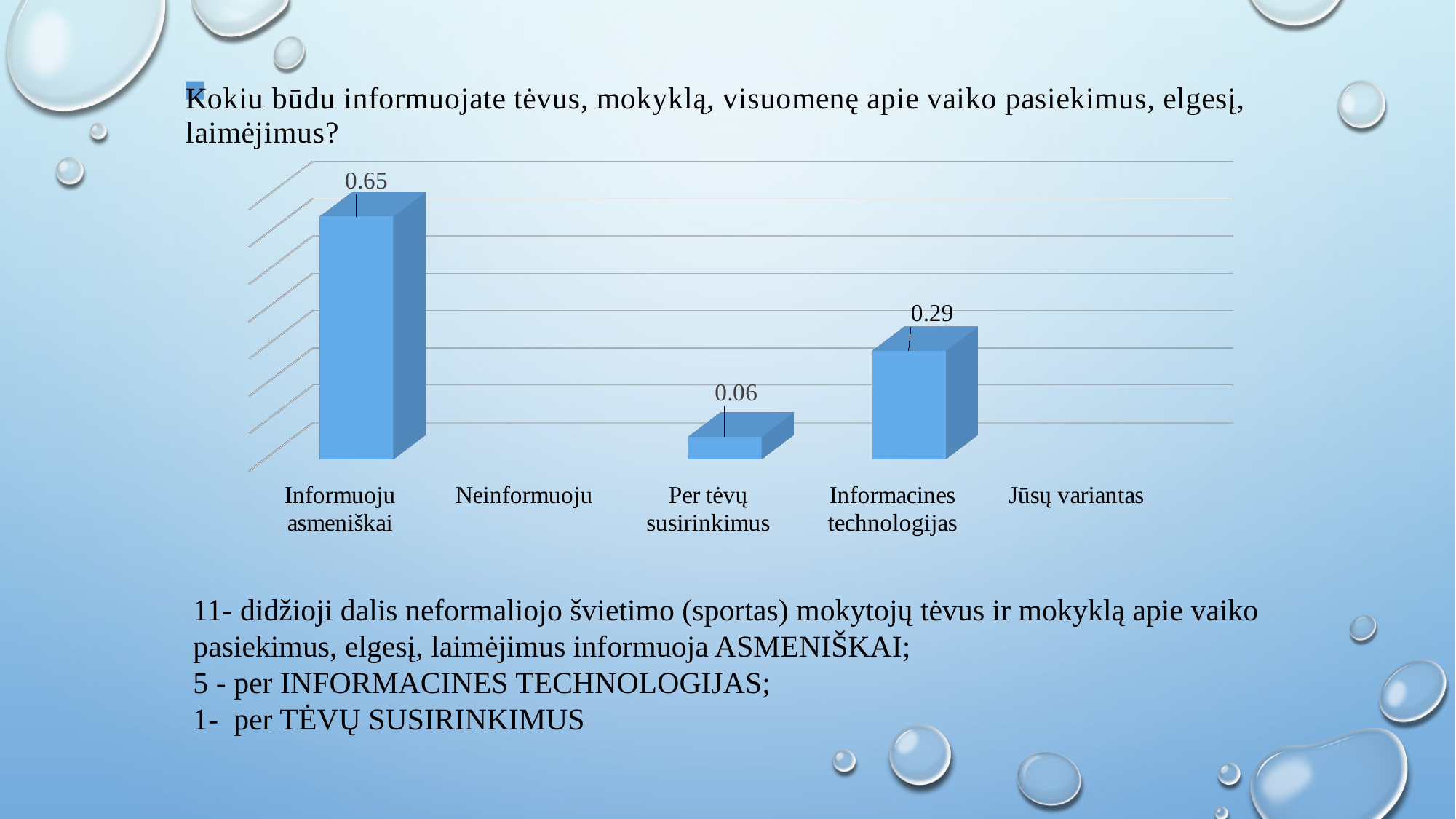
Among the categories with a visible bar, which has the lowest value? Per tėvų susirinkimus What kind of chart is shown on the slide? Bar chart What is the difference between the values for Informacines technologijas and Per tėvų susirinkimus? 0.23 How many categories are shown on the x axis? 5 What question is the chart on the slide answering? Kokiu būdu informuojate tėvus, mokyklą, visuomenę apie vaiko pasiekimus, elgesį, laimėjimus? What is the value for Per tėvų susirinkimus? 0.06 Which is larger, the value for Informacines technologijas or the value for Per tėvų susirinkimus? Informacines technologijas Which category has the highest value? Informuoju asmeniškai What is the value for Informuoju asmeniškai? 0.65 What is the difference between the values for Informuoju asmeniškai and Informacines technologijas? 0.36 What is the value for Informacines technologijas? 0.29 Which categories on the x axis have no visible bar? Neinformuoju and Jūsų variantas